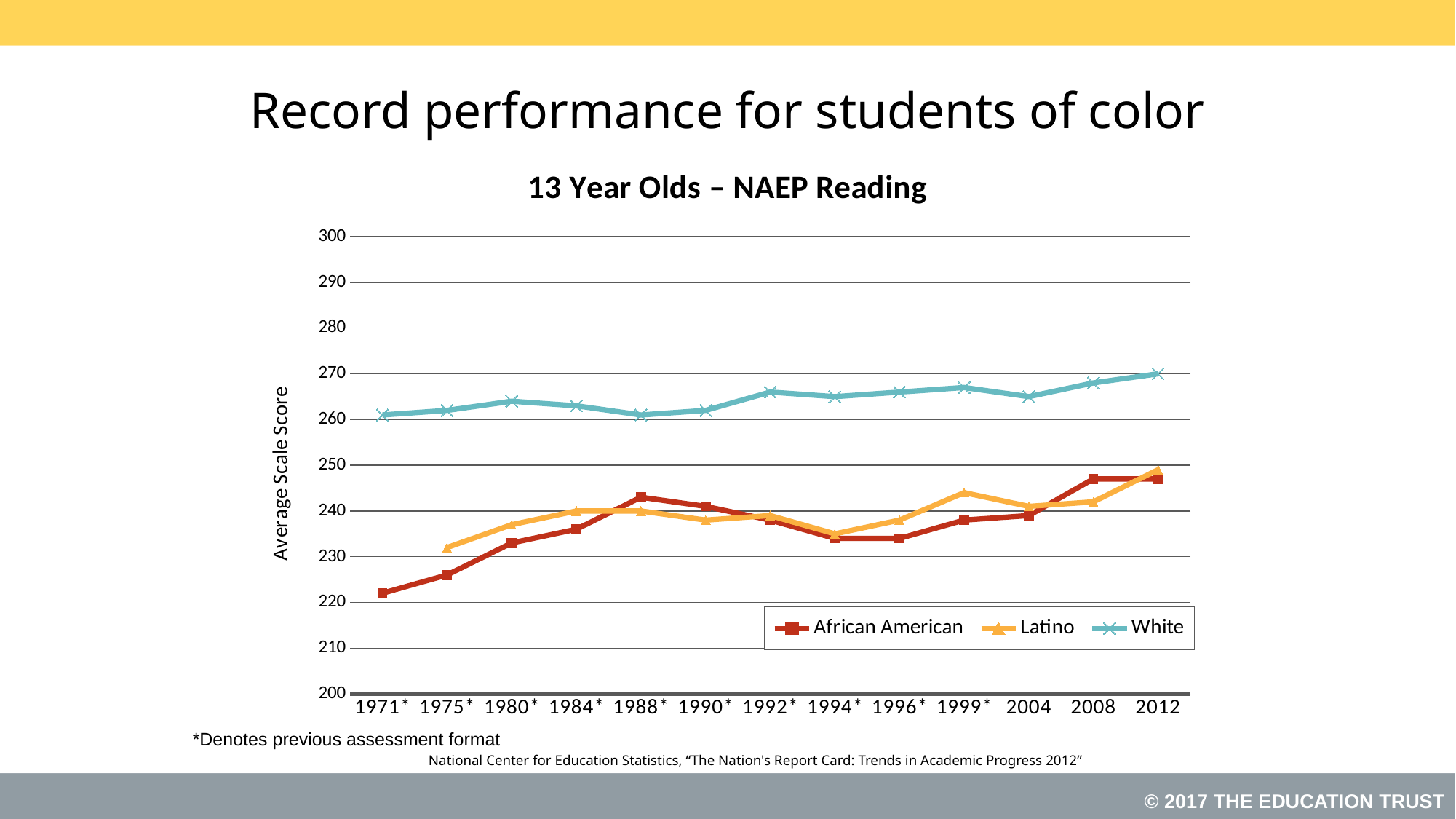
Which series has the highest values across all years shown? White How many series does the legend list? 3 Is the value for African American students in 1994* greater or less than 240? less What is the label on the vertical axis? Average Scale Score Is the value for Latino students in 1999* greater or less than 240? greater In which year is the African American series at its lowest? 1971* Is the value for White students in 1992* greater or less than 260? greater What is the title of the chart? 13 Year Olds – NAEP Reading Does the African American series rise or fall overall from 1971* to 2012? rise How many assessment years are shown along the x axis? 13 What kind of chart is shown on the slide? line chart